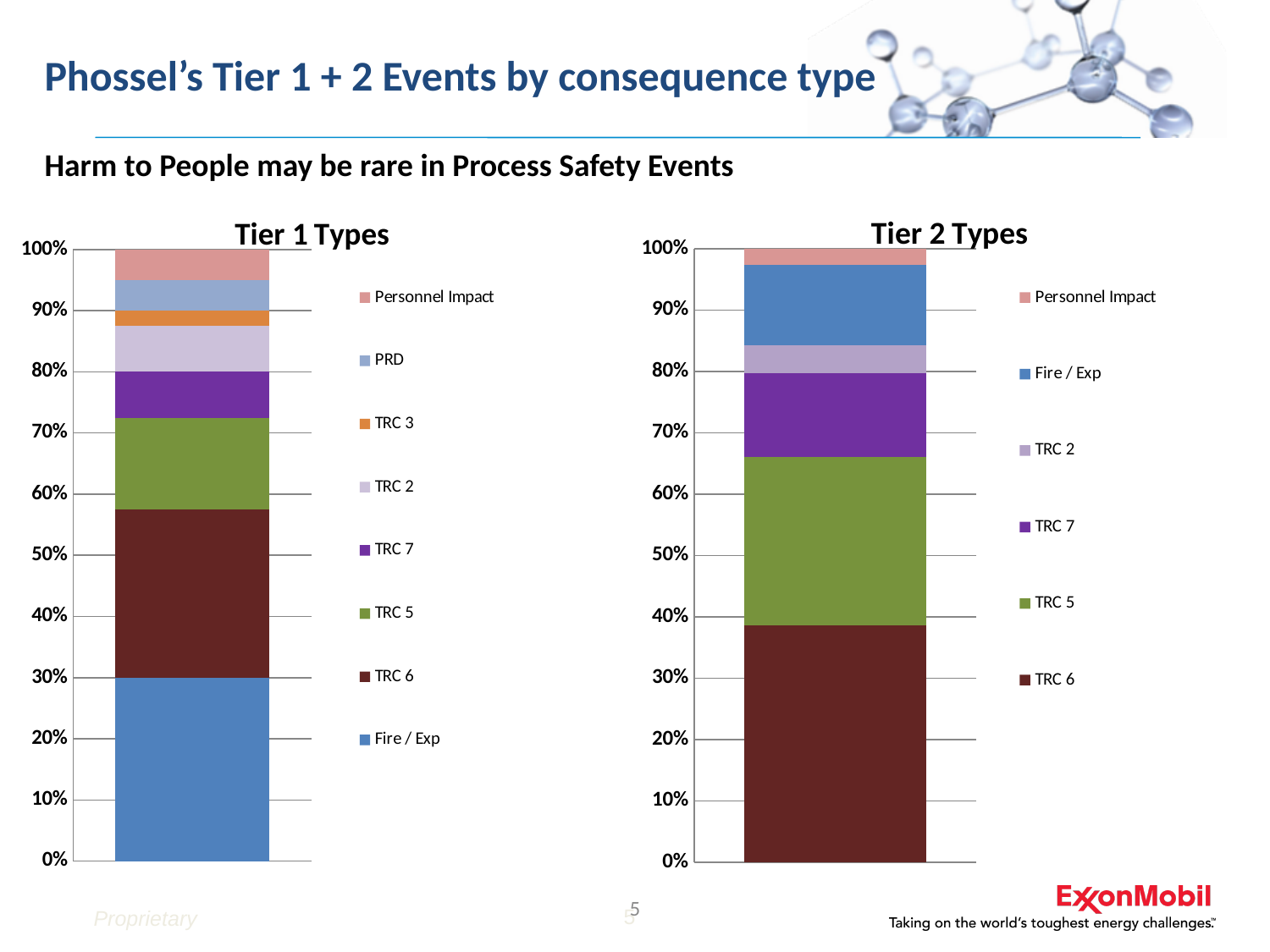
How many series does the legend of the Tier 2 Types chart list? 6 In the Tier 1 Types chart, which segment is larger, TRC 5 or TRC 7? TRC 5 In the Tier 2 Types chart, is the share for TRC 6 greater or less than 30%? greater In the Tier 1 Types chart, which consequence type has the smallest segment? TRC 3 In the Tier 2 Types chart, which consequence type forms the bottom segment of the bar? TRC 6 In the Tier 1 Types chart, is the share for Fire / Exp greater or less than 20%? greater In the Tier 1 Types chart, is the share for Personnel Impact greater or less than 10%? less In the Tier 2 Types chart, which segment is larger, TRC 5 or TRC 2? TRC 5 What kind of chart is the Tier 1 Types chart? Stacked bar chart How many series does the legend of the Tier 1 Types chart list? 8 What value does the top of the stacked bar reach in the Tier 1 Types chart? 100% In the Tier 2 Types chart, which consequence type has the largest segment? TRC 6